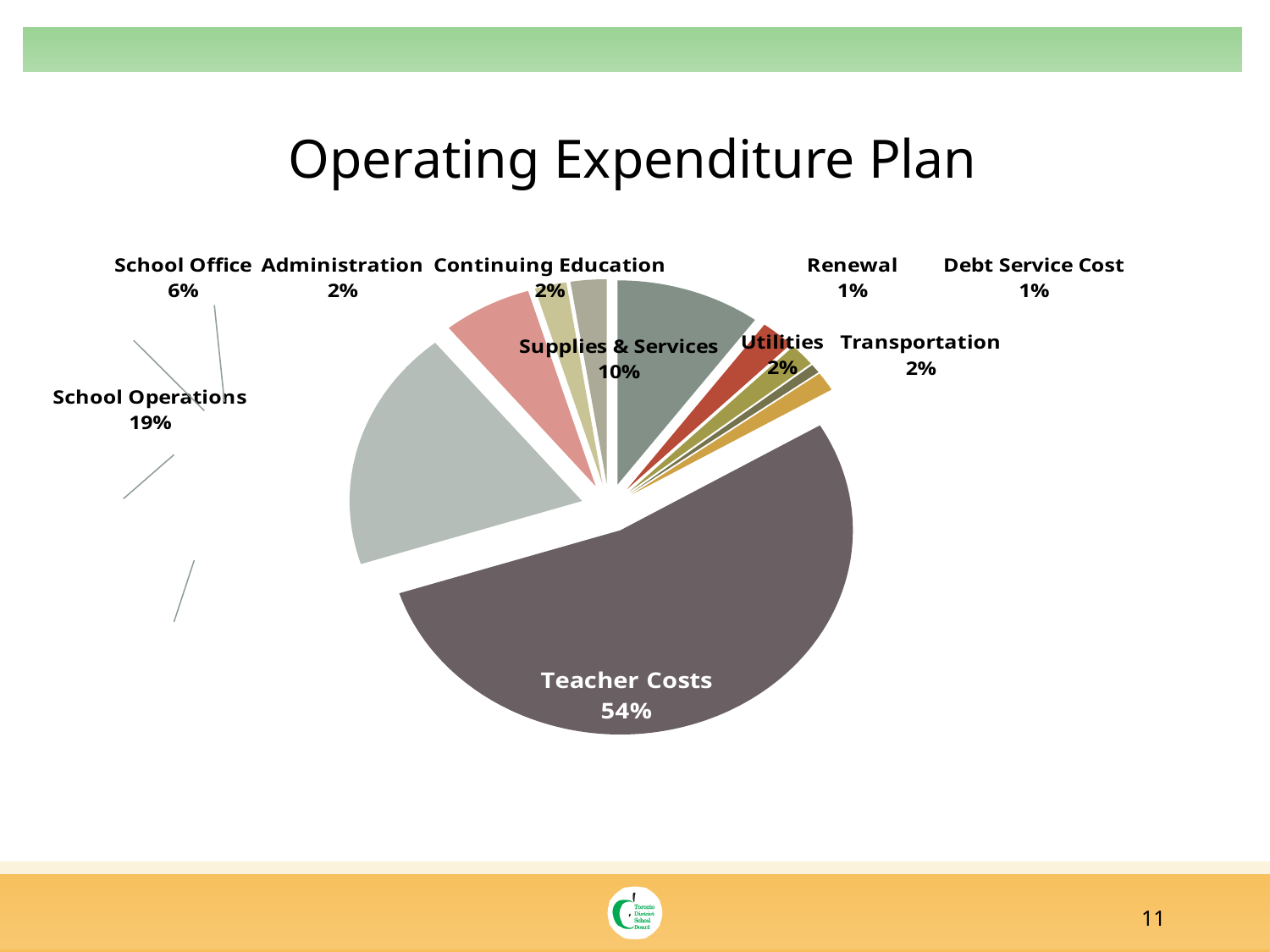
What percentage is shown for Debt Service Cost? 1% What is the title of the chart? Operating Expenditure Plan Which category has the largest slice of the pie? Teacher Costs How many slices does the pie chart have? 10 What is the combined share of Renewal and Debt Service Cost? 2% What kind of chart is shown on the slide? pie chart What percentage is shown for School Operations? 19% What share of the pie is Teacher Costs? 54% What percentage is shown for Supplies & Services? 10% Which is larger, the share for Supplies & Services or the share for School Office? Supplies & Services What percentage is shown for School Office? 6% What is the difference in percentage points between Teacher Costs and School Operations? 35